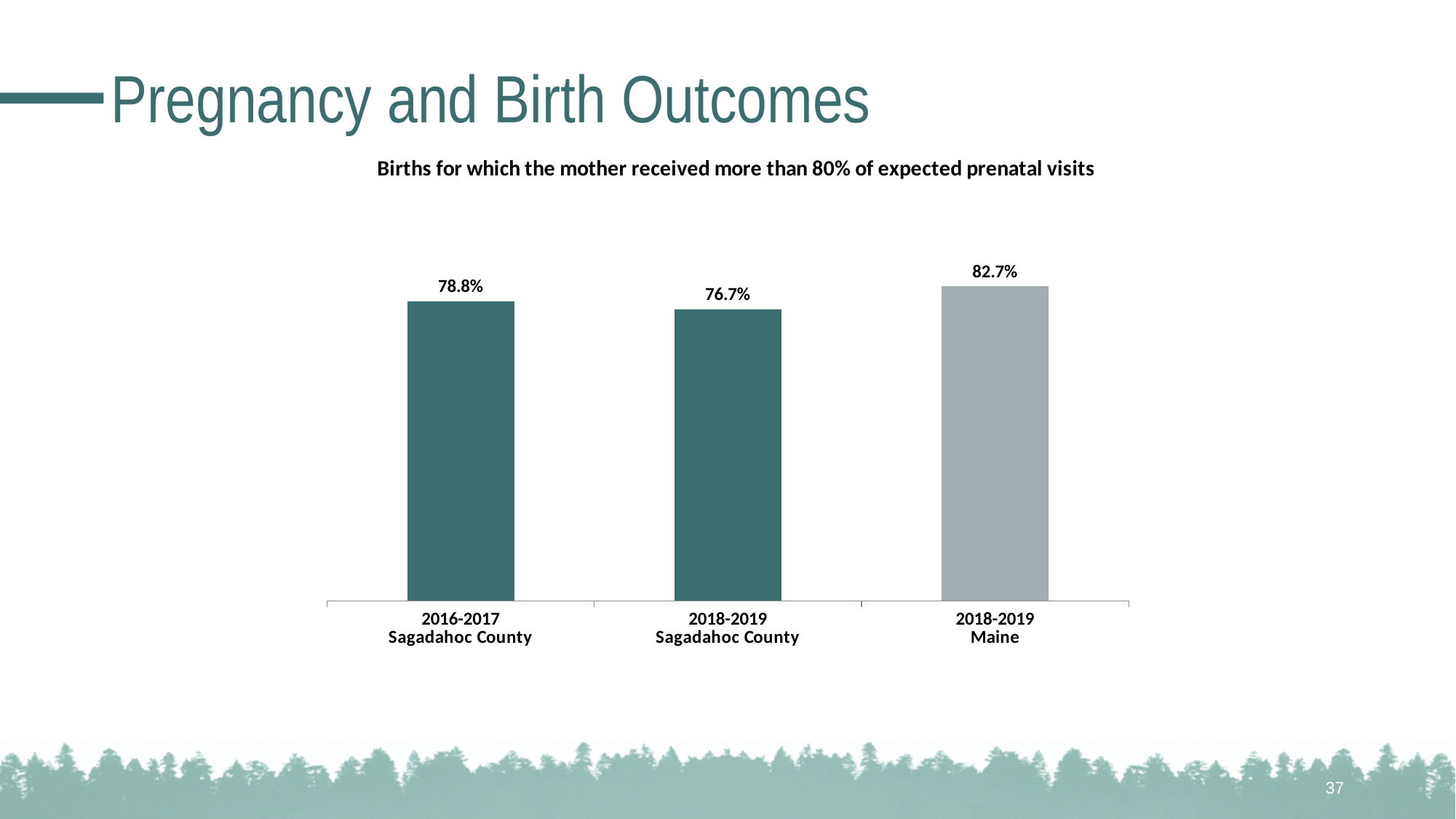
Which category has the highest value? 2018-2019 Maine What is the value for 2018-2019 Sagadahoc County? 76.7% Which is larger, the value for 2016-2017 Sagadahoc County or the value for 2018-2019 Sagadahoc County? 2016-2017 Sagadahoc County What is the difference between the 2016-2017 Sagadahoc County value and the 2018-2019 Sagadahoc County value? 2.1% How many bars are shown in the chart? 3 What is the value for 2016-2017 Sagadahoc County? 78.8% What is the value for 2018-2019 Maine? 82.7% Did the Sagadahoc County value rise or fall from 2016-2017 to 2018-2019? Fall Which category has the lowest value? 2018-2019 Sagadahoc County What is the title of the chart? Births for which the mother received more than 80% of expected prenatal visits What kind of chart is shown on the slide? Bar chart What is the difference between the 2018-2019 Maine value and the 2018-2019 Sagadahoc County value? 6.0%